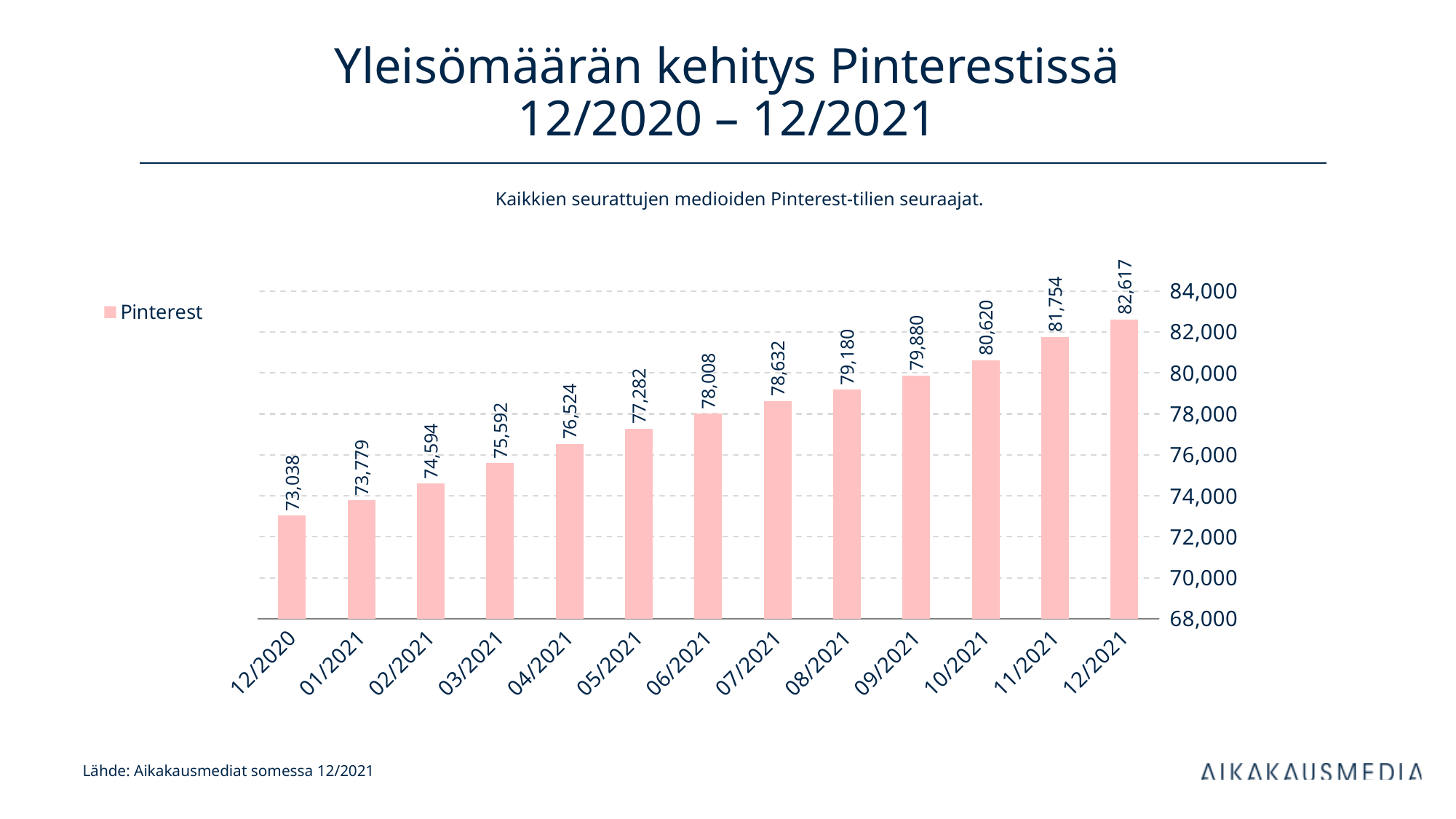
How many months are shown on the x axis? 13 Which is larger, the value for 03/2021 or the value for 09/2021? 09/2021 What is the value for 12/2021? 82,617 Is the value for 04/2021 greater or less than 78,000? less What is the value for 12/2020? 73,038 What is the value for 06/2021? 78,008 Which month has the lowest value? 12/2020 Do the values rise or fall from 12/2020 to 12/2021? rise What is the difference between the values for 11/2021 and 10/2021? 1,134 What kind of chart is shown on the slide? bar chart What is the difference between the values for 12/2021 and 12/2020? 9,579 Which month has the highest value? 12/2021